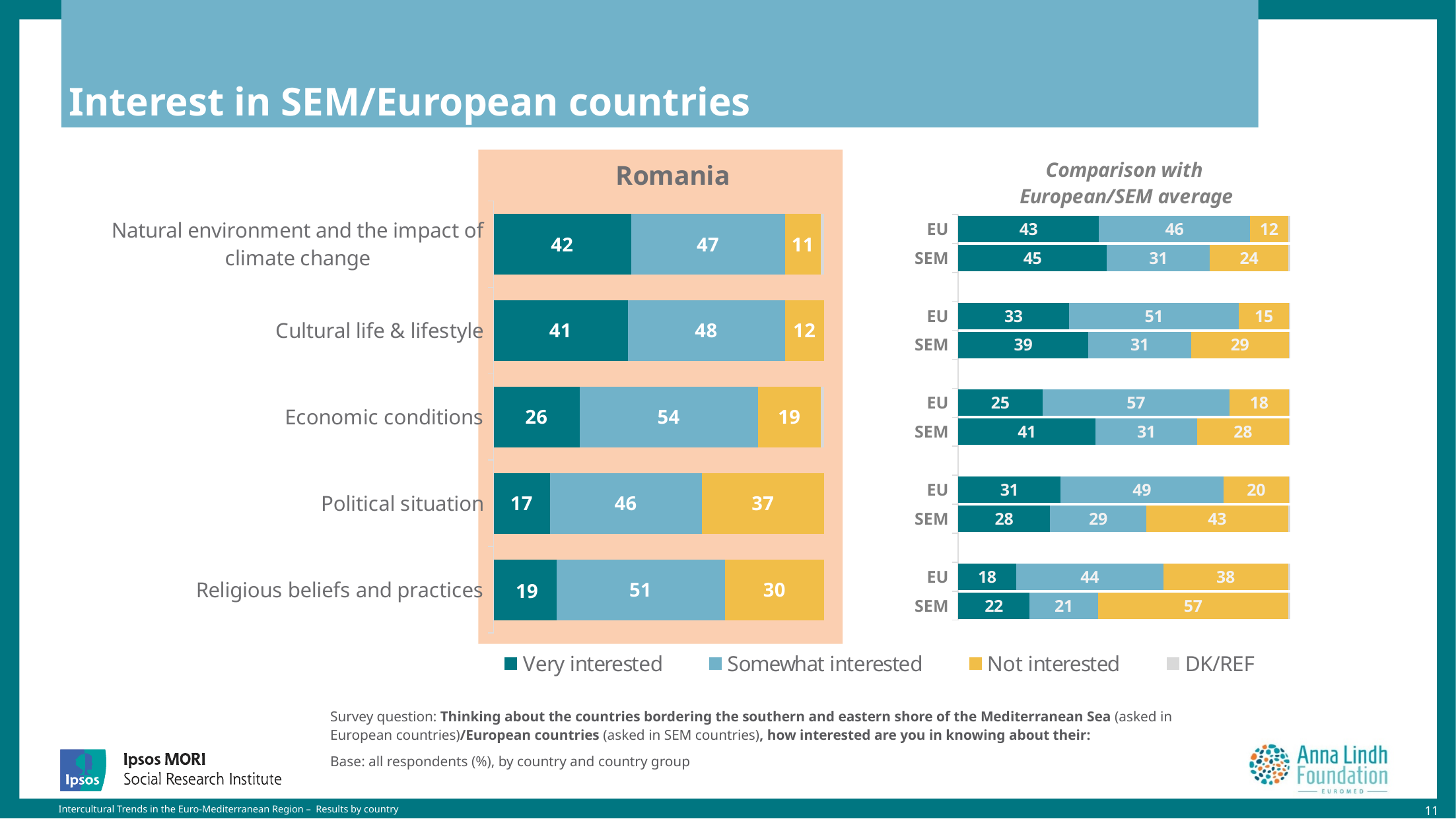
How many topics are shown in the Romania chart? 5 In the Romania chart, which topic has the highest 'Very interested' value? Natural environment and the impact of climate change In the Romania chart, what percentage is 'Very interested' in the natural environment and the impact of climate change? 42 How many series does the legend list? 4 In the Romania chart, which topic has the lowest 'Very interested' value? Political situation In the Romania chart, what is the difference between the 'Somewhat interested' values for economic conditions and political situation? 8 What kind of chart is the Romania chart? Stacked bar chart In the Comparison with European/SEM average chart, what is the difference between the SEM and EU 'Very interested' values for economic conditions? 16 In the Comparison with European/SEM average chart, what is the SEM 'Not interested' value for religious beliefs and practices? 57 In the Romania chart, what is the 'Not interested' value for the political situation? 37 In the Comparison with European/SEM average chart, what is the EU 'Somewhat interested' value for economic conditions? 57 In the Romania chart, which is larger: the 'Not interested' value for religious beliefs and practices or for economic conditions? Religious beliefs and practices